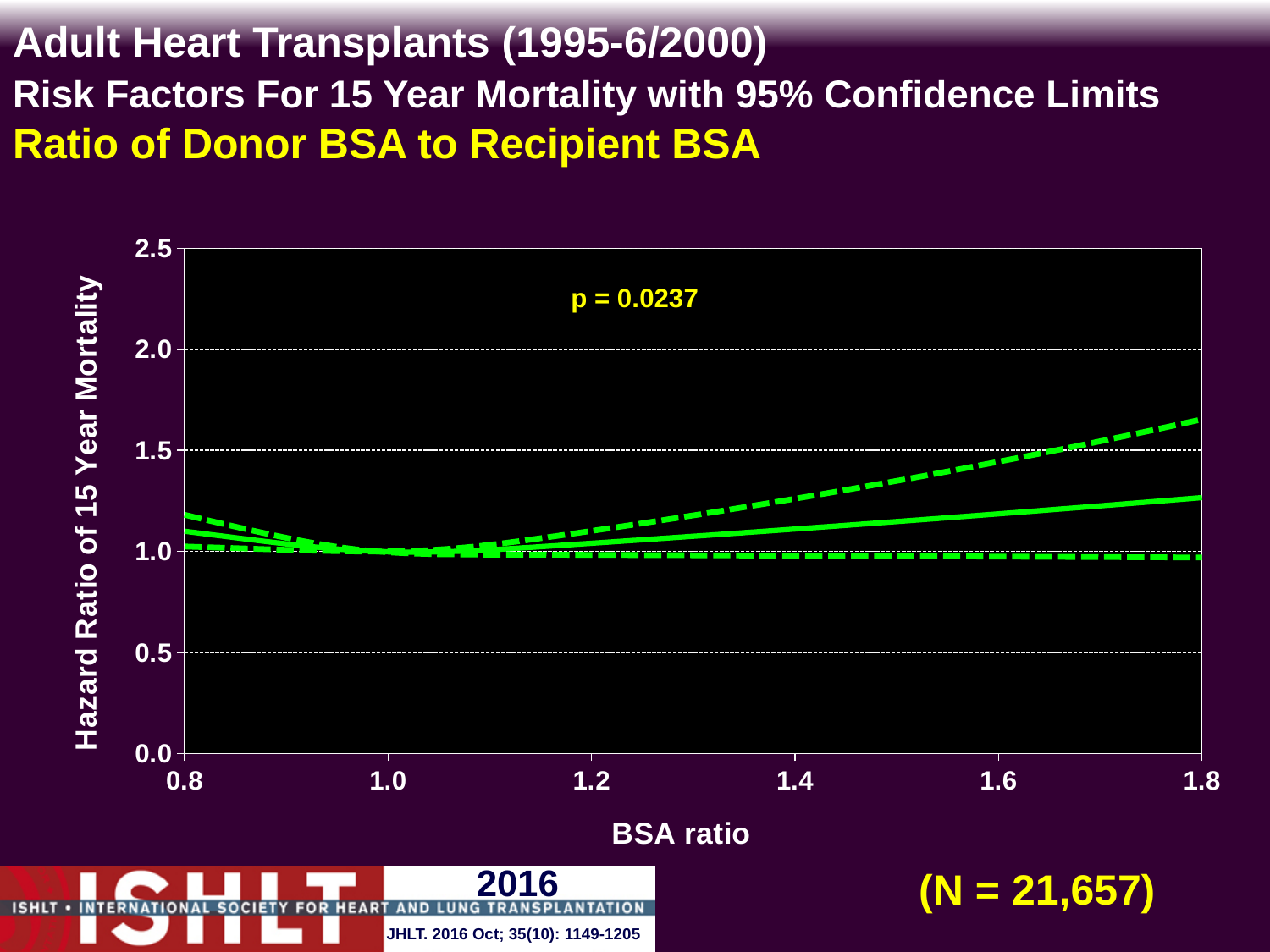
What kind of chart is shown on the slide? Line chart Is the hazard ratio of the solid line at a BSA ratio of 1.8 greater or less than 1.0? greater What is the highest value labelled on the y axis? 2.5 How many lines are plotted on the chart? 3 Is the upper dashed confidence limit at a BSA ratio of 1.8 greater or less than 1.5? greater What p-value is printed on the chart? p = 0.0237 How many tick labels are shown on the x axis (BSA ratio)? 6 Does the solid hazard ratio line rise or fall as the BSA ratio increases from 1.0 to 1.8? rise Is the upper dashed confidence limit at a BSA ratio of 1.4 greater or less than 1.5? less What sample size (N) is shown on the slide? N = 21,657 What is the lowest BSA ratio labelled on the x axis? 0.8